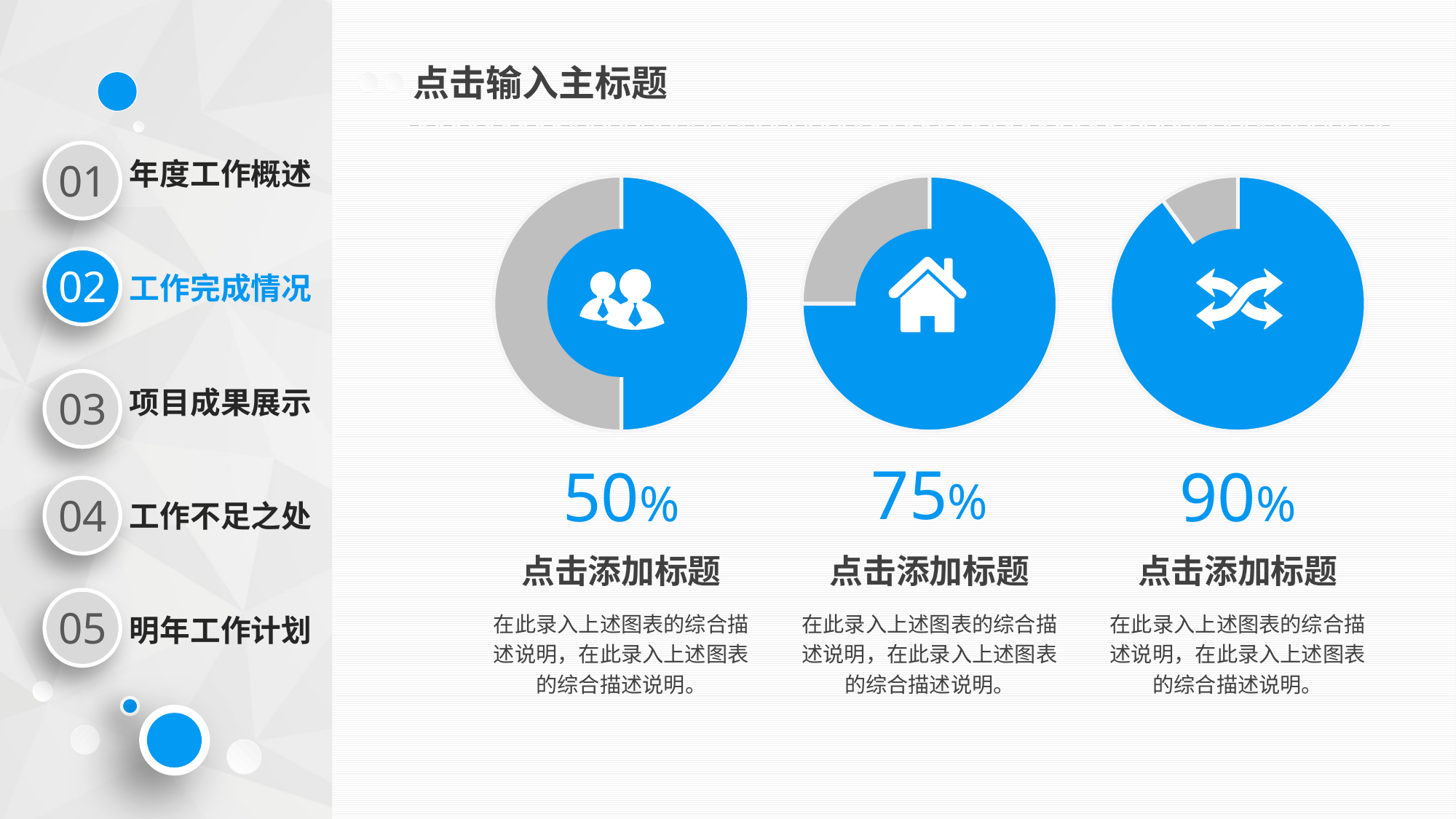
What is the difference between the percentage of the middle chart and the percentage of the left chart? 25% What percentage is shown below the middle chart? 75% Which of the three charts shows the lowest percentage? The left chart (50%) What kind of chart is used to show the percentages on the slide? doughnut chart What percentage is shown below the right chart? 90% Do the percentages increase or decrease from the left chart to the right chart? increase What percentage is shown below the left chart? 50% What colour is used for the filled (completed) portion of each pie chart? blue Is the percentage of the middle chart larger or smaller than that of the right chart? smaller Which of the three charts shows the highest percentage? The right chart (90%) How many pie charts are shown on the slide? 3 What is the difference between the percentage of the right chart and the percentage of the left chart? 40%